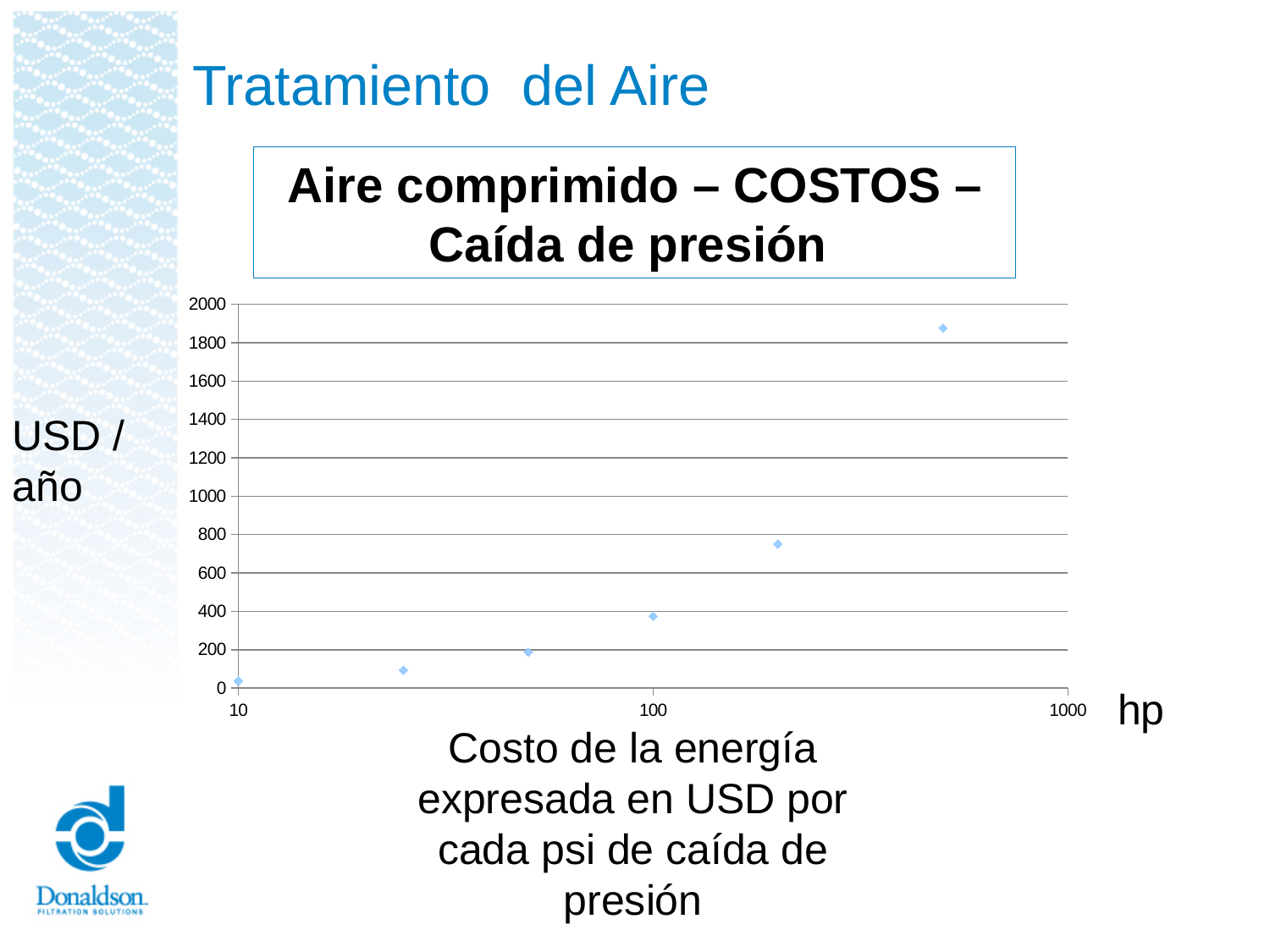
Is the highest plotted value greater or less than 1800? greater Is the value at 100 hp greater or less than 200? greater How many data points are plotted on the chart? 6 What label is shown for the vertical axis of the chart? USD / año What is the title of the chart? Aire comprimido – COSTOS – Caída de presión How many plotted points have a value above 1000? 1 Does the point with the highest value lie at the largest or the smallest hp value on the chart? largest Is the value at 10 hp greater or less than 200? less What kind of chart is shown on the slide? scatter chart Do the plotted values rise or fall as hp increases along the x axis? rise